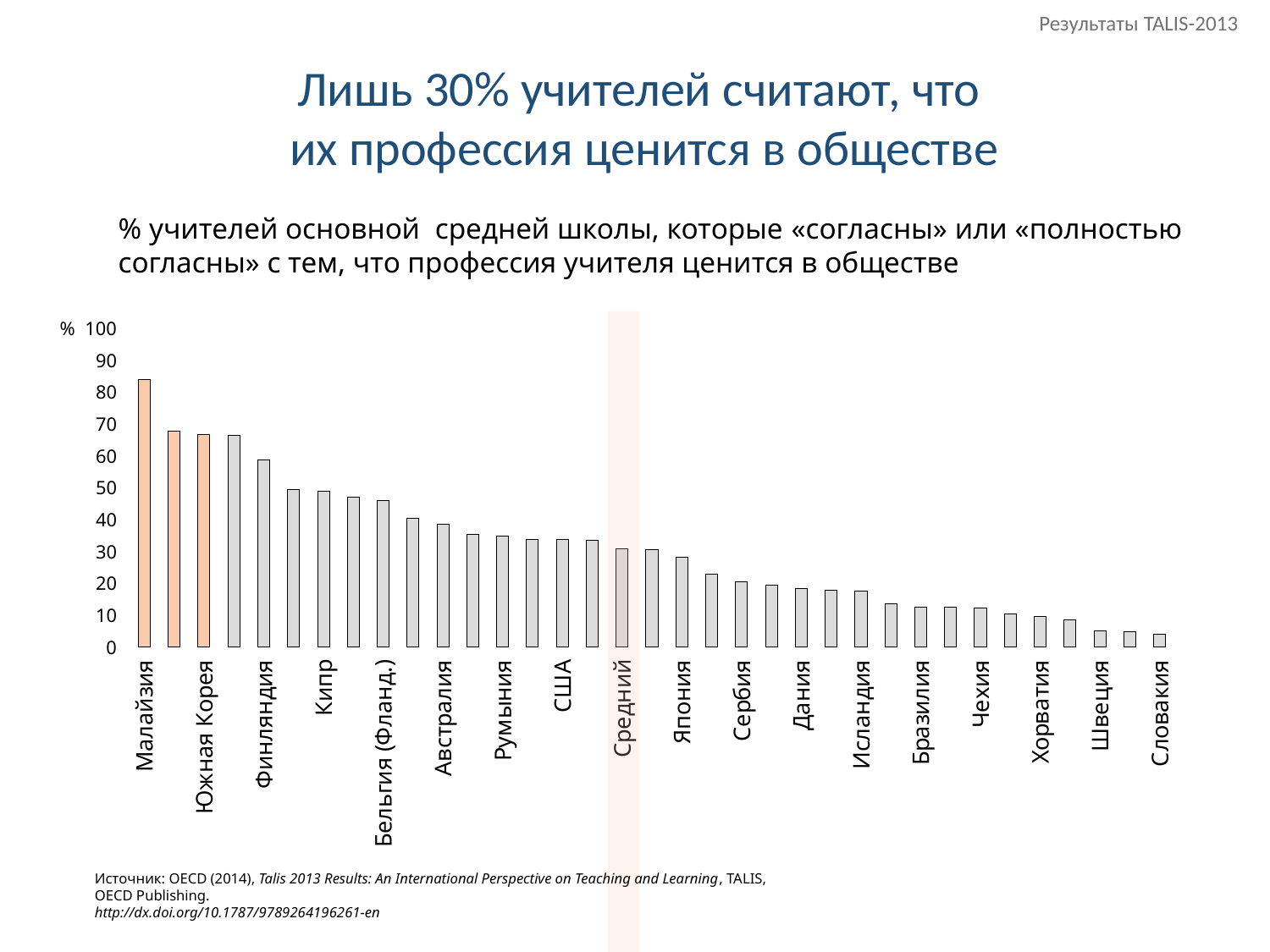
Is the value for Дания greater or less than 20? less Is the value for Япония greater or less than 30? less Is the value for Бельгия (Фланд.) greater or less than 40? greater What kind of chart is shown on the slide? bar chart Which country has the highest share of teachers who agree that the teaching profession is valued in society? Малайзия Which has a larger value, Малайзия or Южная Корея? Малайзия Do the values rise or fall moving from left to right along the x axis? fall Which has a larger value, Япония or Дания? Япония